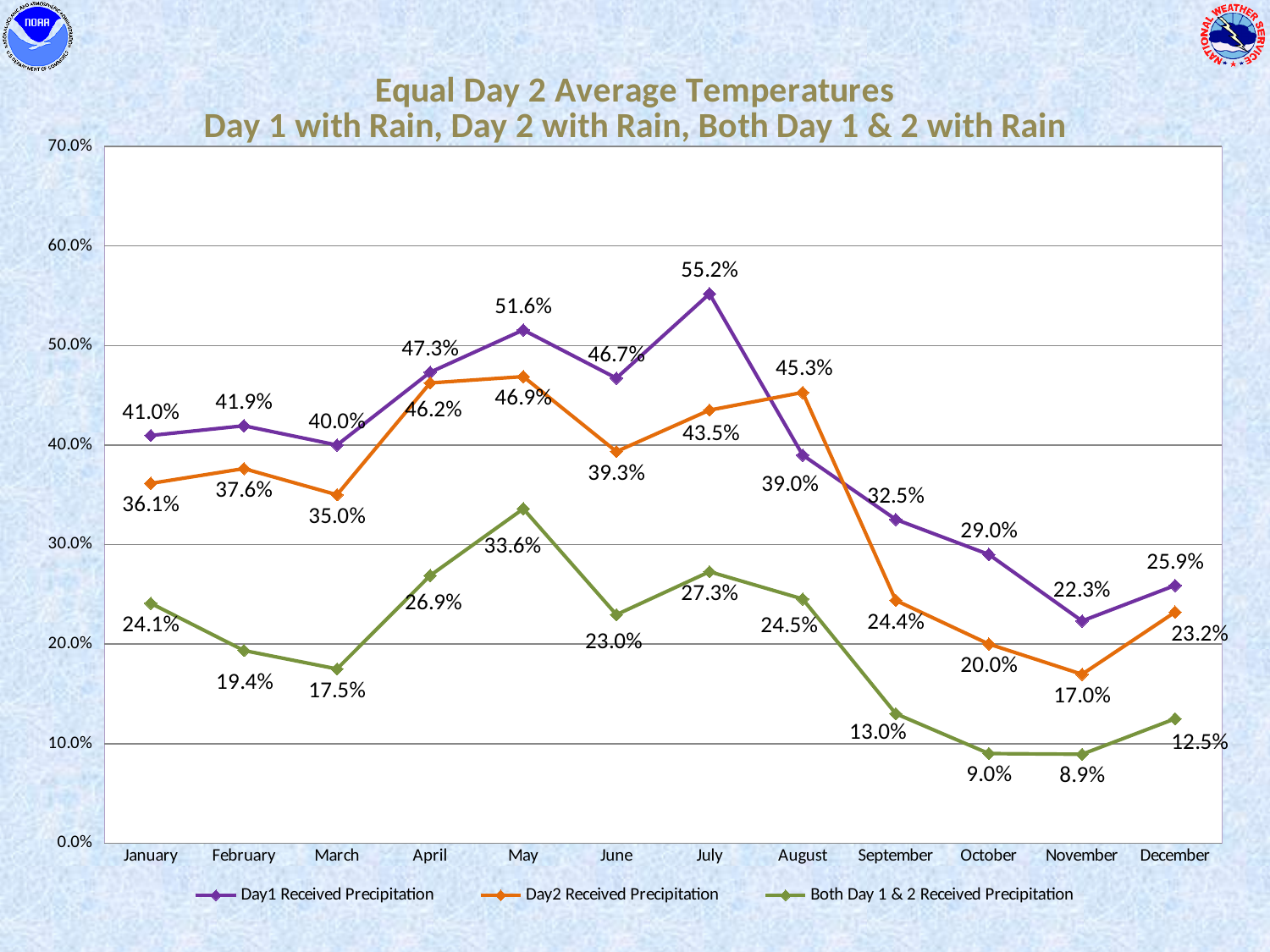
Which is larger in August: Day1 Received Precipitation or Day2 Received Precipitation? Day2 Received Precipitation What is the difference between Day1 Received Precipitation and Day2 Received Precipitation in January? 4.9% What is the value for Day1 Received Precipitation in July? 55.2% What kind of chart is shown on the slide? Line chart How many months are plotted on the x axis? 12 In which month is Day1 Received Precipitation highest? July What is the value for Both Day 1 & 2 Received Precipitation in May? 33.6% How many series does the legend list? 3 Is the value for Day1 Received Precipitation in May greater or less than 50.0%? greater What is the value for Day2 Received Precipitation in August? 45.3% In which month is Both Day 1 & 2 Received Precipitation lowest? November Does Day2 Received Precipitation rise or fall from August to November? Fall